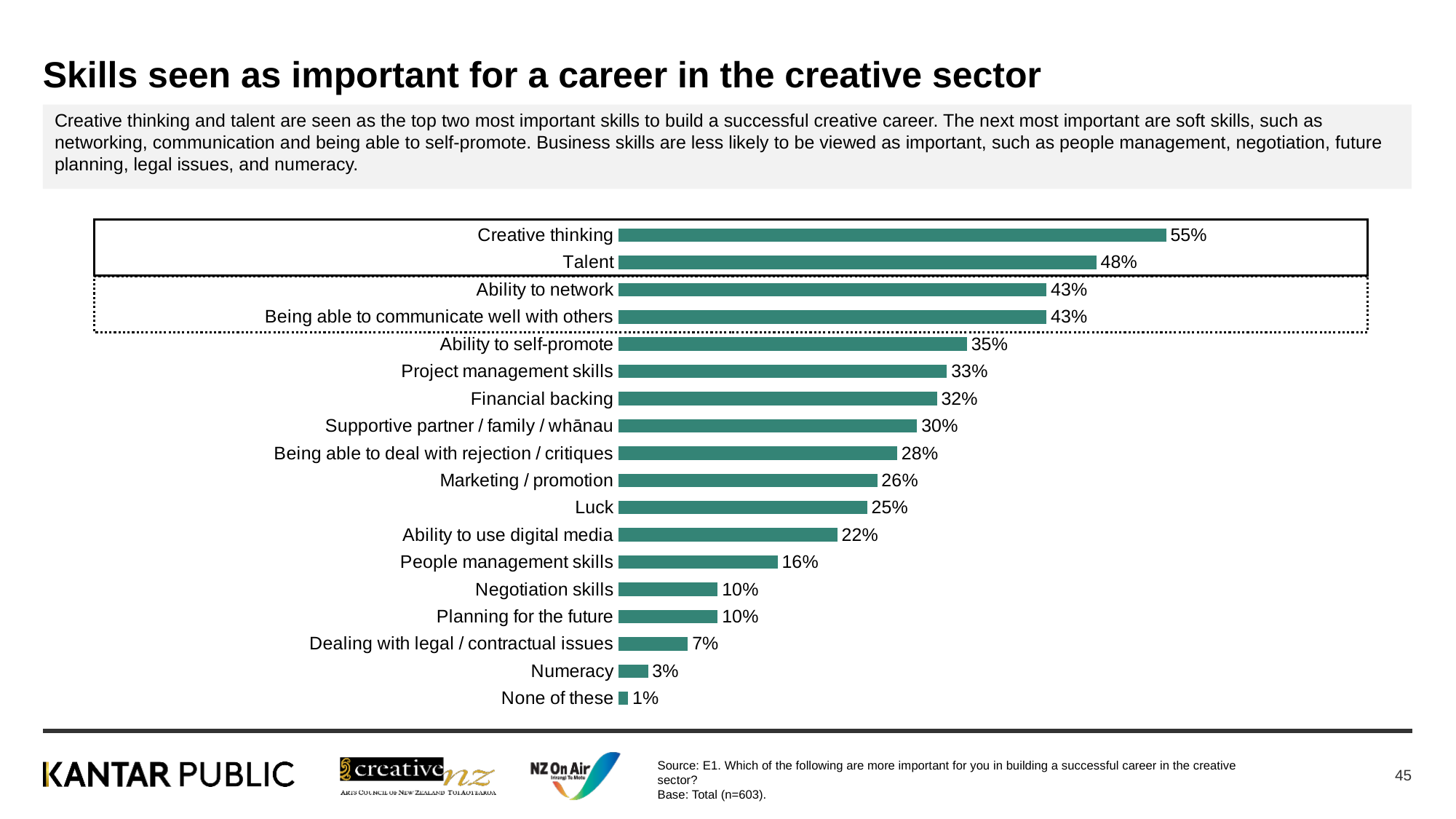
What is the difference in percentage points between Creative thinking and Talent? 7 Which category has the lowest percentage in the chart? None of these What kind of chart is shown on the slide? Bar chart What percentage of respondents selected Creative thinking as important for a creative career? 55% How many categories are shown in the chart? 18 Which skill has the highest percentage in the chart? Creative thinking What is the difference in percentage points between Ability to self-promote and People management skills? 19 What percentage is shown for Dealing with legal / contractual issues? 7% Which two categories both have a value of 43%? Ability to network and Being able to communicate well with others Which is larger, the value for Financial backing or the value for Marketing / promotion? Financial backing What is the value shown for Numeracy? 3% What is the value shown for Luck? 25%